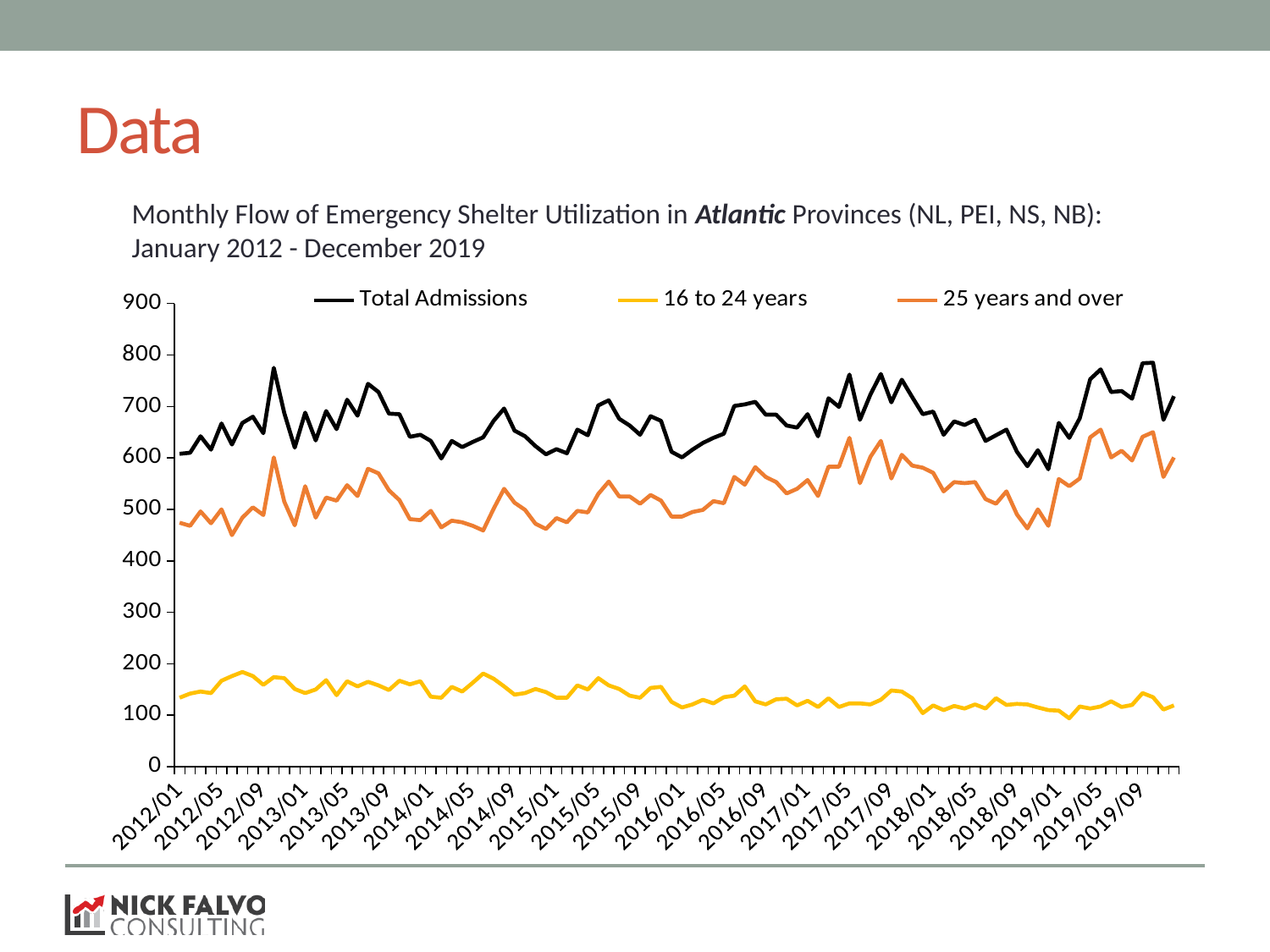
What kind of chart is shown on the slide? line chart Is the value for 16 to 24 years at 2012/01 greater or less than 200? less Is the value for Total Admissions at 2012/01 greater or less than 500? greater Which series is plotted in black? Total Admissions Does the 16 to 24 years series generally rise or fall from 2012 to 2019? fall How many series does the legend list? 3 Is the value for 25 years and over at 2012/01 greater or less than 500? less Which series has the lowest values throughout the period? 16 to 24 years At 2012/01, which is larger: 25 years and over or 16 to 24 years? 25 years and over What period does the chart title say the data covers? January 2012 - December 2019